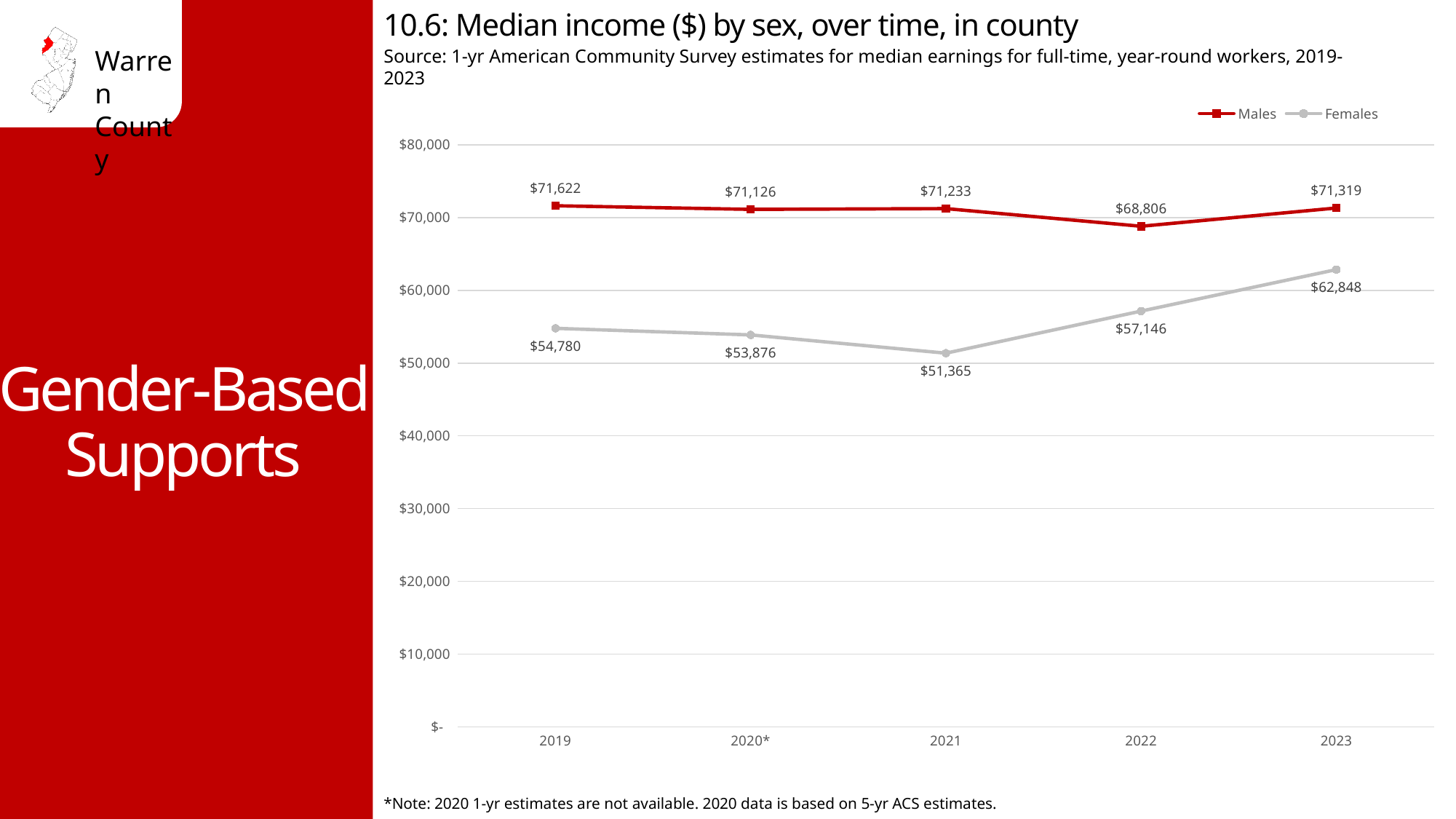
What is the difference between male and female median income in 2023? $8,471 What kind of chart is shown on the slide? Line chart In which year was the median income for females highest? 2023 What was the median income for males in 2022? $68,806 What was the median income for males in 2019? $71,622 Which was higher in 2020*, the median income for males or for females? Males What was the median income for females in 2023? $62,848 In which year was the median income for females lowest? 2021 How many series does the legend list? 2 What was the median income for females in 2021? $51,365 How many years are shown on the x axis? 5 In which year was the median income for males lowest? 2022